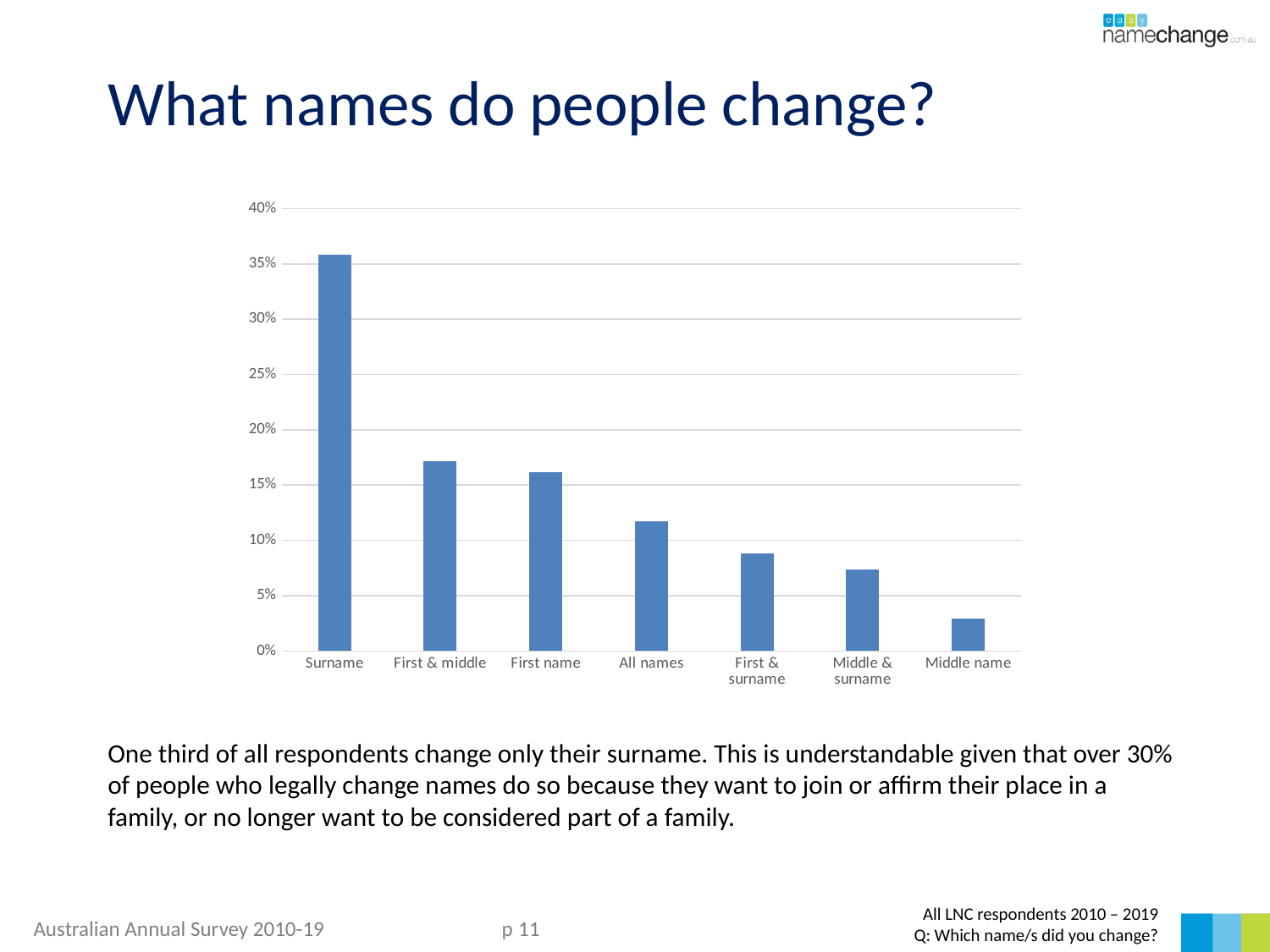
What kind of chart is shown on the slide? bar chart Is the value for All names greater or less than 10%? greater Is the value for Middle name greater or less than 5%? less Do the values rise or fall moving from left to right along the x axis? fall What is the title of the slide containing the chart? What names do people change? Which category has the highest value? Surname Is the value for Surname greater or less than 35%? greater Which category has the lowest value? Middle name How many categories are shown on the x axis? 7 Which is larger, the value for All names or the value for First & surname? All names